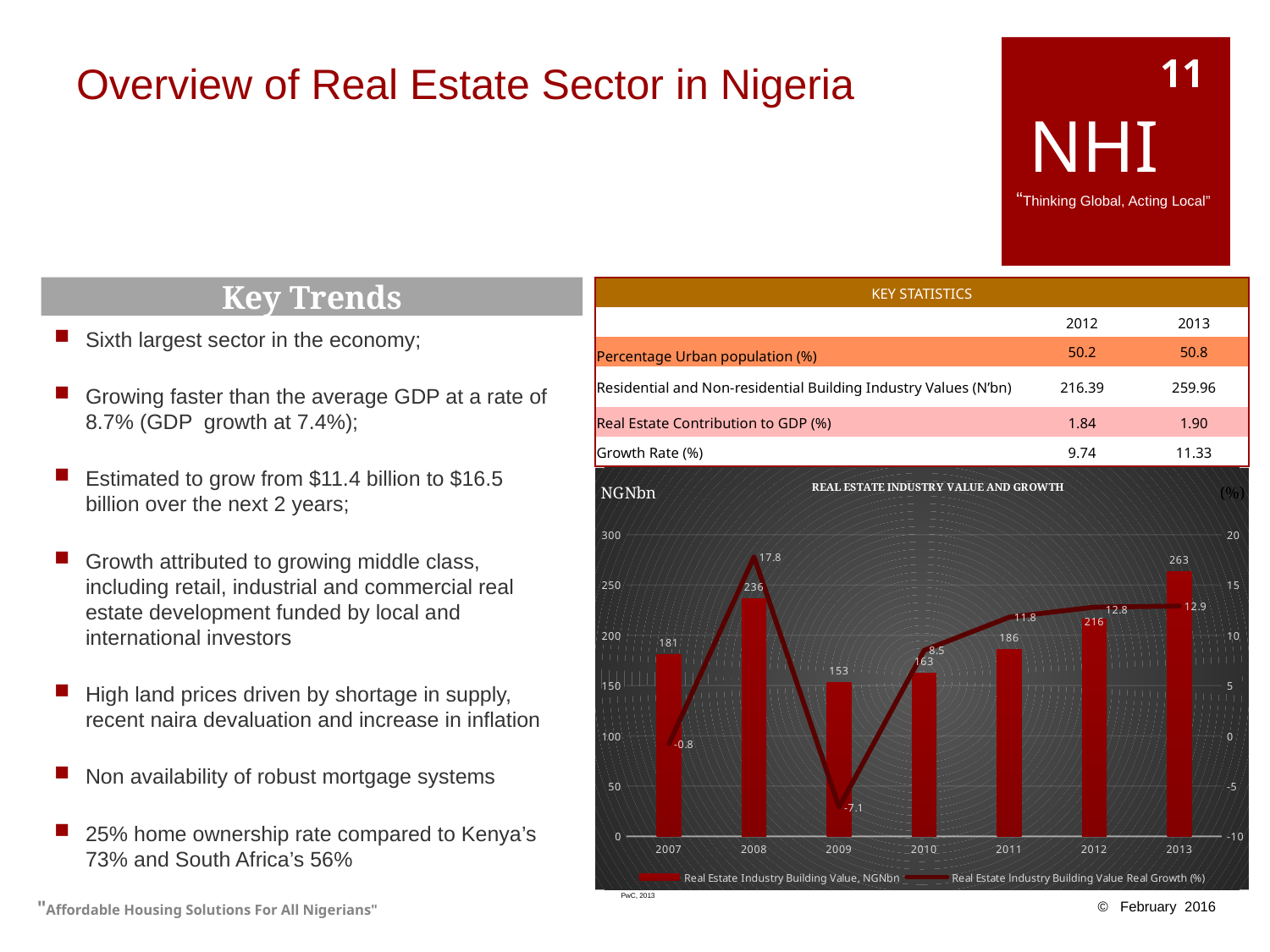
What is the Real Estate Industry Building Value (NGNbn) for 2009? 153 What is the Real Estate Industry Building Value (NGNbn) for 2013? 263 What is the title of the chart? REAL ESTATE INDUSTRY VALUE AND GROWTH Which year has the lowest Real Estate Industry Building Value Real Growth (%)? 2009 What is the difference in Real Estate Industry Building Value (NGNbn) between 2013 and 2012? 47 Which year has the highest Real Estate Industry Building Value (NGNbn)? 2013 Does the Real Estate Industry Building Value (NGNbn) rise or fall from 2009 to 2013? rise What kind of chart is used to show the Real Estate Industry Building Value, NGNbn series? bar chart Which year has the larger Real Estate Industry Building Value (NGNbn), 2007 or 2011? 2011 How many years are shown on the x axis of the chart? 7 How many series does the chart legend list? 2 What is the Real Estate Industry Building Value Real Growth (%) for 2008? 17.8